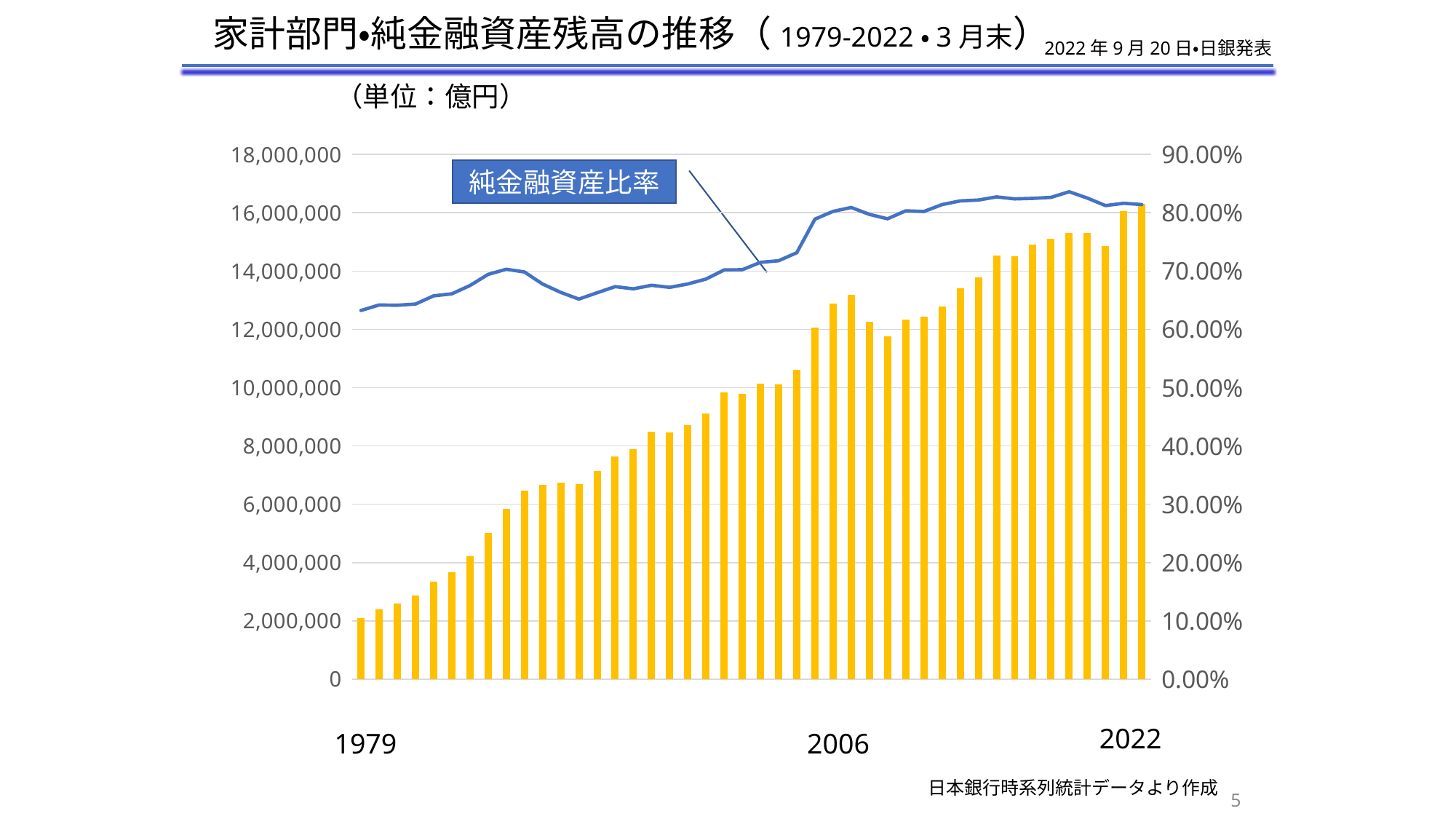
How many bars (years) are plotted in the chart? 44 What kind of chart is shown on the slide? A bar chart combined with a line chart Is the bar value for 2006 greater or less than 10,000,000? greater Is the bar value for 2022 greater or less than 14,000,000? greater Do the bar values generally rise or fall from 1979 to 2022? rise Is the bar value for 1979 greater or less than 4,000,000? less Which is larger, the bar for 1979 or the bar for 2022? 2022 What is the label shown for the line series in the chart? 純金融資産比率 Which year has the lowest bar for 純金融資産残高? 1979 What unit is stated for the bar values on the slide? 億円